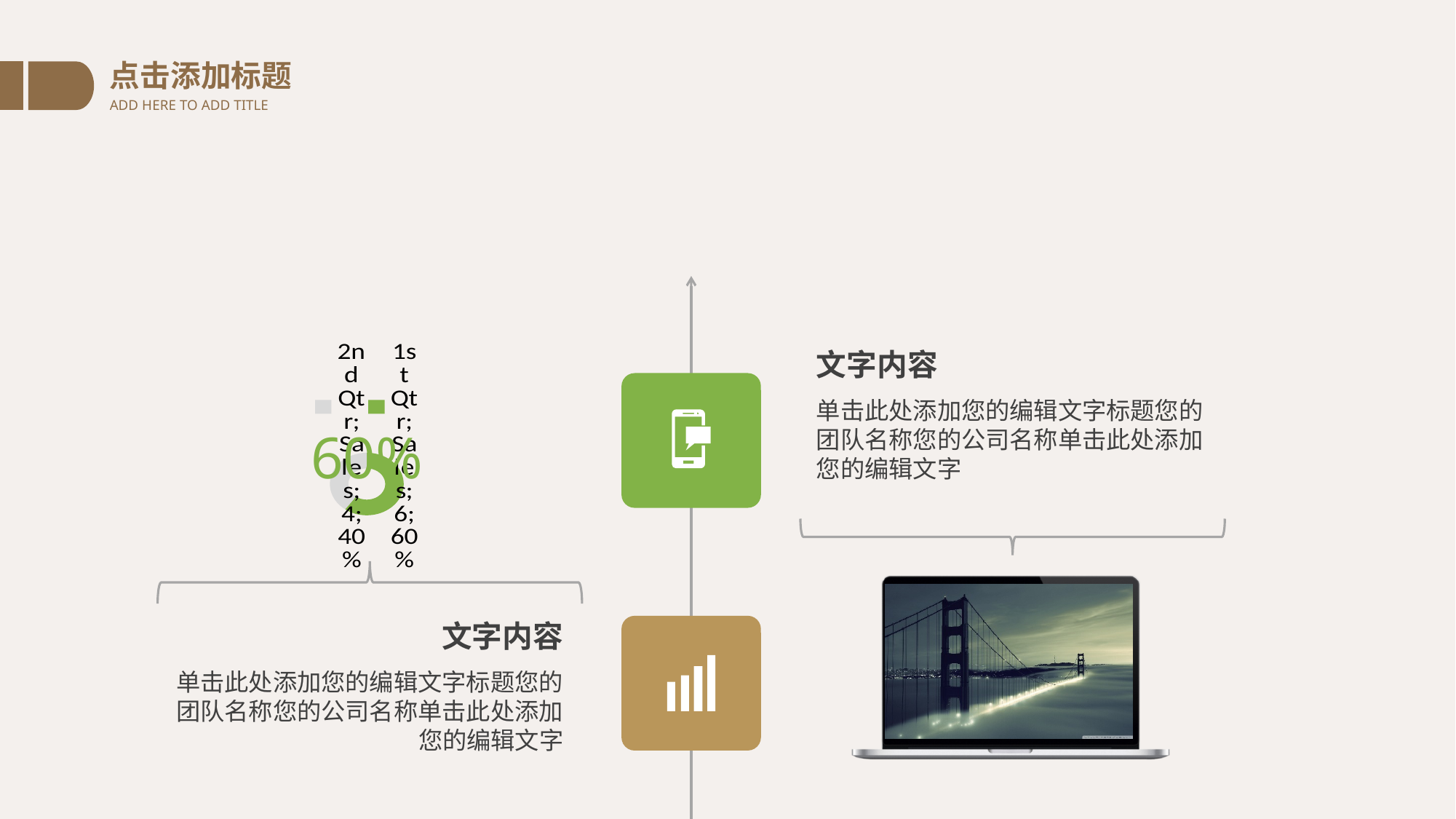
What is the Sales value for 1st Qtr in the chart? 6 What is the name of the data series shown in the chart? Sales What percentage share does the 2nd Qtr slice have in the chart? 40% How many slices does the chart have? 2 Which is larger, the Sales value for 1st Qtr or for 2nd Qtr? 1st Qtr What percentage share does the 1st Qtr slice have in the chart? 60% What is the Sales value for 2nd Qtr in the chart? 4 What is the difference between the Sales values for 1st Qtr and 2nd Qtr? 2 Which quarter has the smallest slice in the chart? 2nd Qtr What is the total of the Sales values shown in the chart? 10 Which quarter has the largest slice in the chart? 1st Qtr What colour is the 1st Qtr slice in the chart? Green